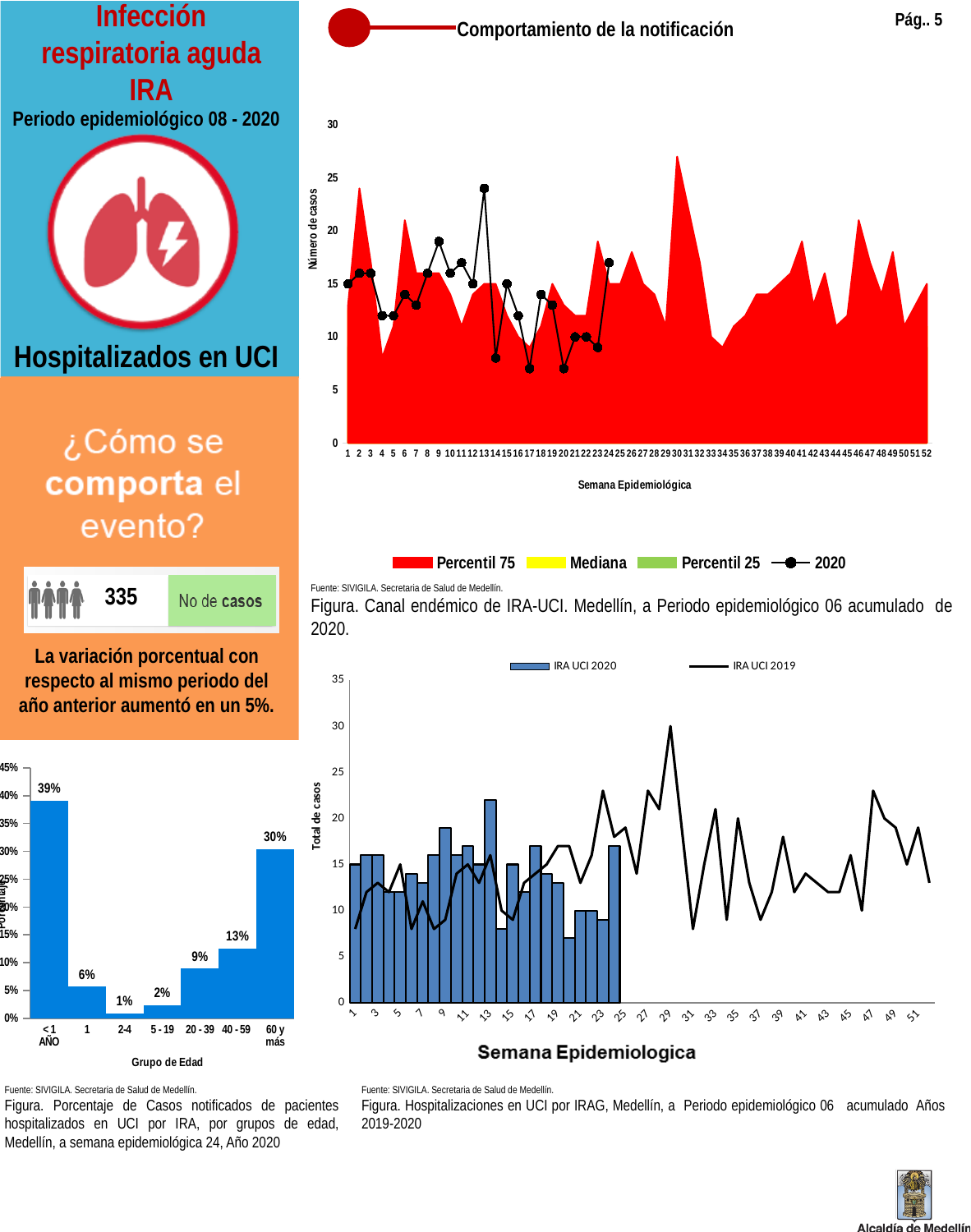
In the bottom-left chart of percentage of cases by age group, what is the value for the '< 1 AÑO' group? 39% In the bottom-left chart of percentage of cases by age group, which age group has the highest percentage? < 1 AÑO In the bottom-left chart of percentage of cases by age group, how many age groups are shown? 7 In the bottom-left chart of percentage of cases by age group, what is the value for the '60 y más' group? 30% In the top-right chart 'Canal endémico de IRA-UCI', what is the label of the x axis? Semana Epidemiológica In the bottom-left chart of percentage of cases by age group, which is larger, the value for '20 - 39' or the value for '1'? 20 - 39 In the bottom-left chart of percentage of cases by age group, what is the difference between the '< 1 AÑO' group and the '60 y más' group? 9% In the bottom-right chart 'Hospitalizaciones en UCI por IRAG', how many series does the legend list? 2 What kind of chart is the bottom-left chart of percentage of cases by age group? bar chart In the bottom-left chart of percentage of cases by age group, what is the value for the '40 - 59' group? 13% In the bottom-left chart of percentage of cases by age group, which age group has the lowest percentage? 2-4 In the top-right chart 'Canal endémico de IRA-UCI', how many entries does the legend list? 4